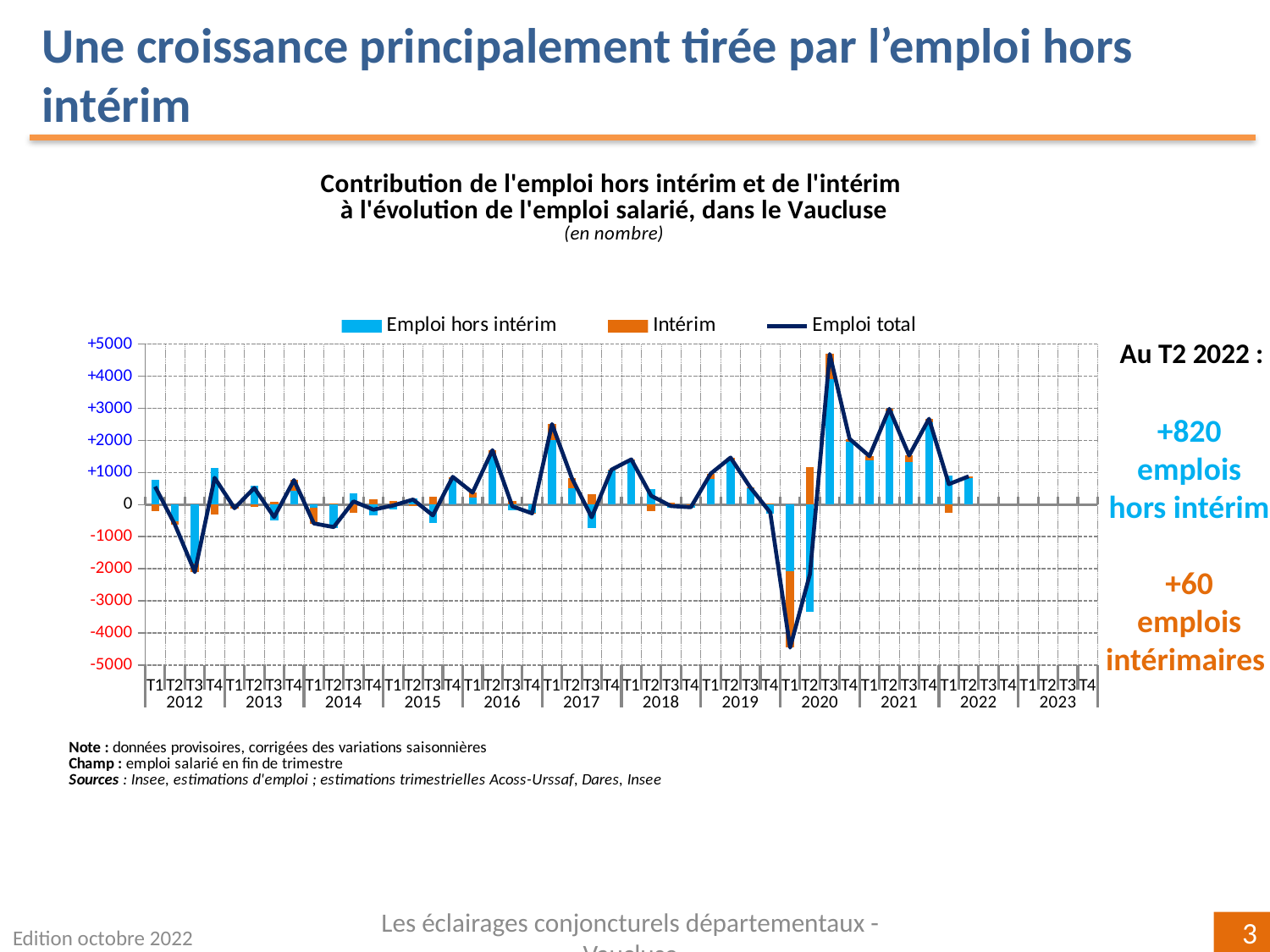
Is the value of Emploi total at T3 2020 greater or less than 4000? greater Is the value of Emploi total at T1 2020 greater or less than -4000? less What is the title of the chart? Contribution de l'emploi hors intérim et de l'intérim à l'évolution de l'emploi salarié, dans le Vaucluse In which quarter does the Emploi total line reach its highest point? T3 2020 In which quarter does the Emploi total line reach its lowest point? T1 2020 According to the slide, what is the value for Emploi hors intérim at T2 2022? +820 Is the value for Emploi hors intérim at T2 2020 greater or less than -2000? less What kind of chart is shown on the slide? A combined bar and line chart According to the slide, what is the value for Intérim at T2 2022? +60 At T2 2022, which is larger: Emploi hors intérim or Intérim? Emploi hors intérim How many series does the chart legend list? 3 What are the three series named in the chart legend? Emploi hors intérim, Intérim, Emploi total